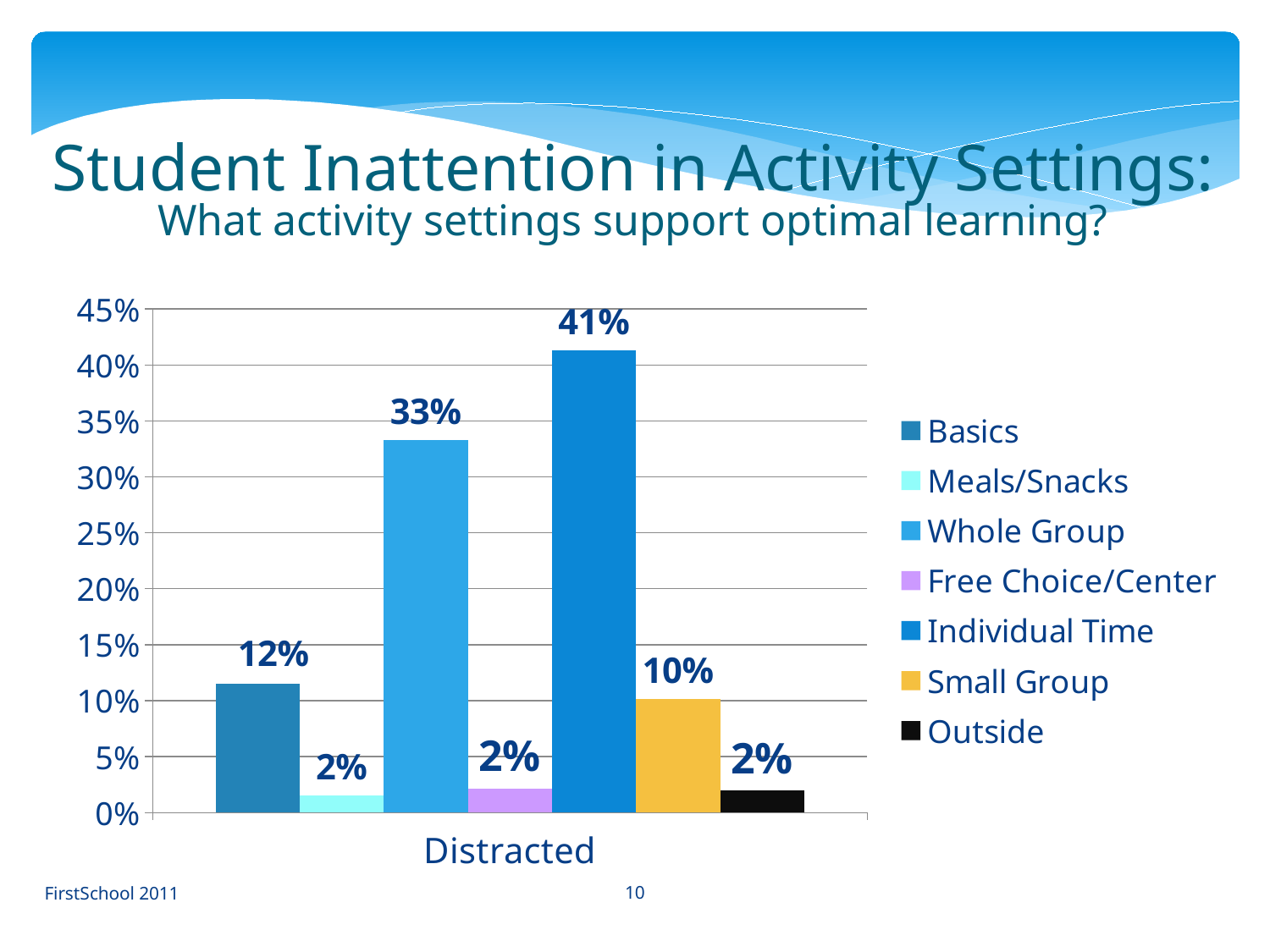
Is the value for Whole Group greater or less than 30%? greater Which series has the highest value in the Distracted category? Individual Time What is the difference between the Individual Time and Whole Group values? 8% What is the value for Whole Group in the Distracted category? 33% What is the category label shown on the x axis? Distracted What kind of chart is shown on the slide? Bar chart What is the value for Basics in the Distracted category? 12% Which is larger, the value for Basics or the value for Small Group? Basics What is the value for Small Group in the Distracted category? 10% What is the difference between the Basics and Small Group values? 2% How many series does the legend list? 7 What is the value for Individual Time in the Distracted category? 41%